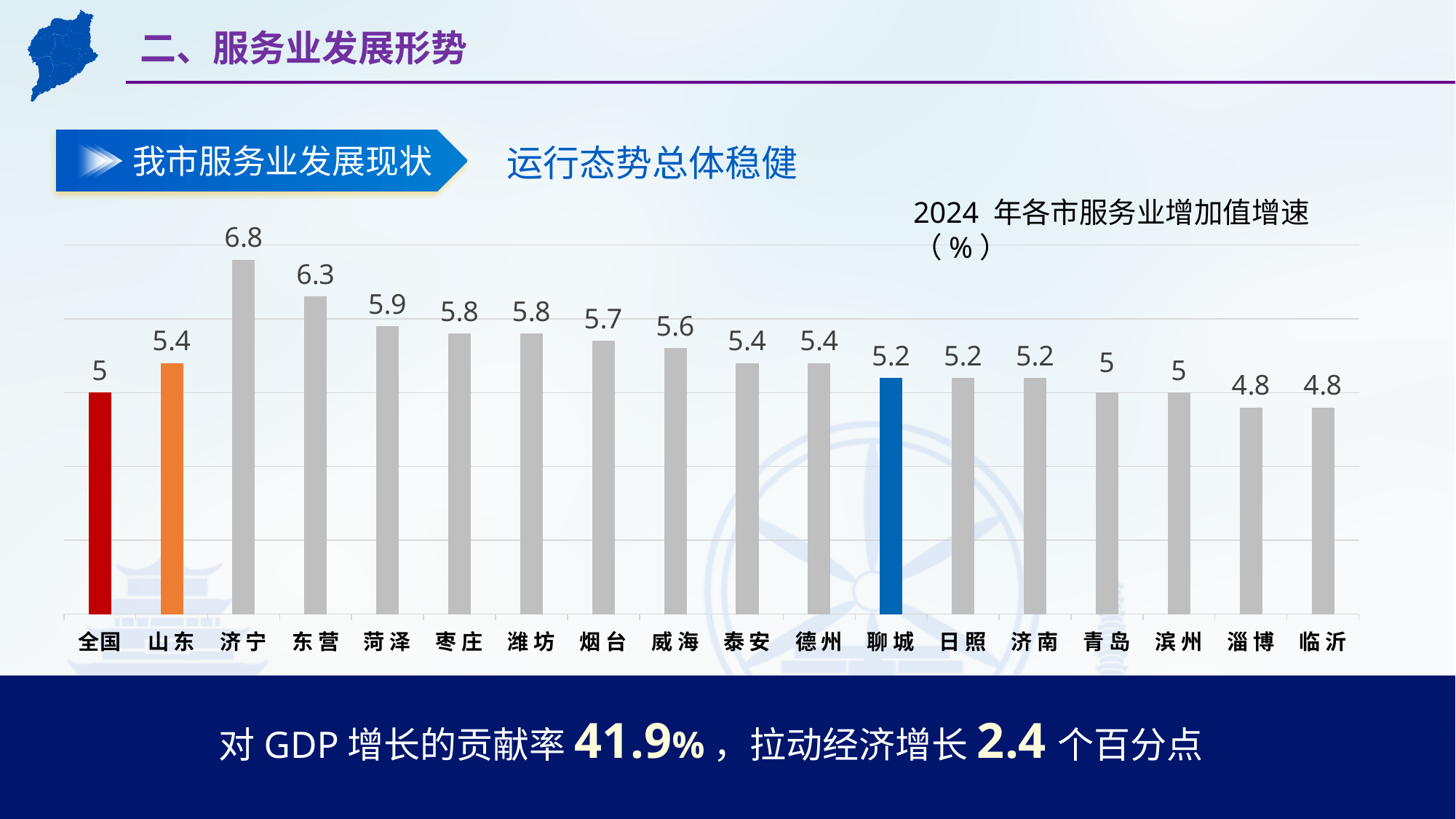
Do the values rise or fall along the x axis from 济宁 to 临沂? fall Which category has the highest value in the chart? 济宁 What colour is the bar for 聊城? blue What is the value for 山东 in the chart? 5.4 What is the value for 全国 in the chart? 5 How many categories are shown on the x axis of the chart? 18 Which has a larger value, 东营 or 菏泽? 东营 What is the value for 济宁 in the chart? 6.8 What is the difference between the values for 济宁 and 聊城? 1.6 What kind of chart is shown on the slide? bar chart What is the difference between the values for 山东 and 全国? 0.4 What is the value for 聊城 in the chart? 5.2